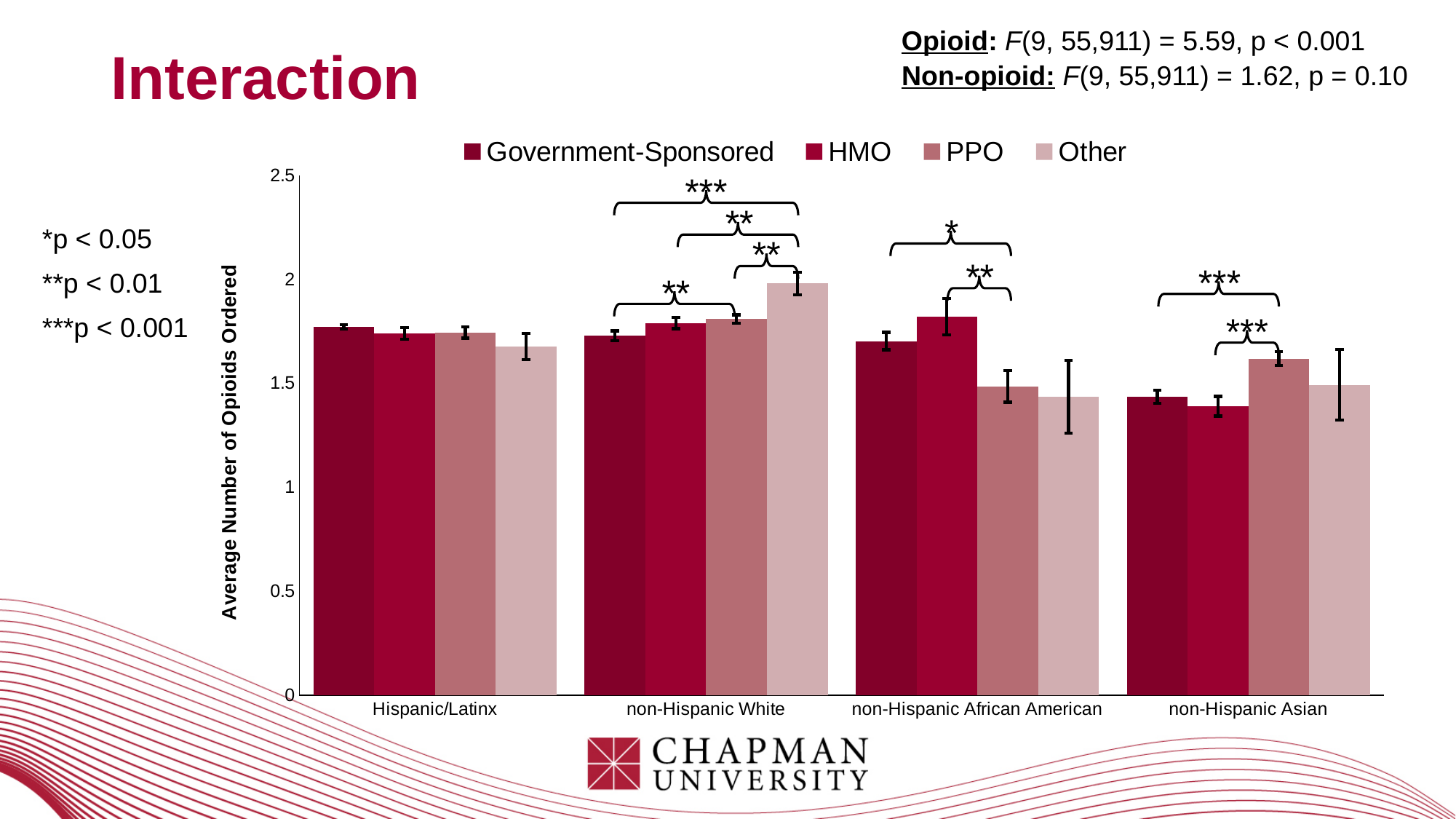
Within the non-Hispanic White group, which series has the highest bar? Other What is the title of the y axis? Average Number of Opioids Ordered Which is larger: the Other bar for non-Hispanic White or the Other bar for Hispanic/Latinx? non-Hispanic White Within the non-Hispanic African American group, which series has the highest bar? HMO Is the value for HMO in the non-Hispanic Asian group greater or less than 1.5? less How many series does the legend list? 4 What kind of chart is shown on the slide? bar chart How many racial/ethnic categories are shown on the x axis? 4 Within the non-Hispanic Asian group, which series has the highest bar? PPO Which is larger: the PPO bar for non-Hispanic Asian or the PPO bar for non-Hispanic African American? non-Hispanic Asian Which series is listed first in the legend? Government-Sponsored Is the value for Other in the non-Hispanic White group greater or less than 1.5? greater